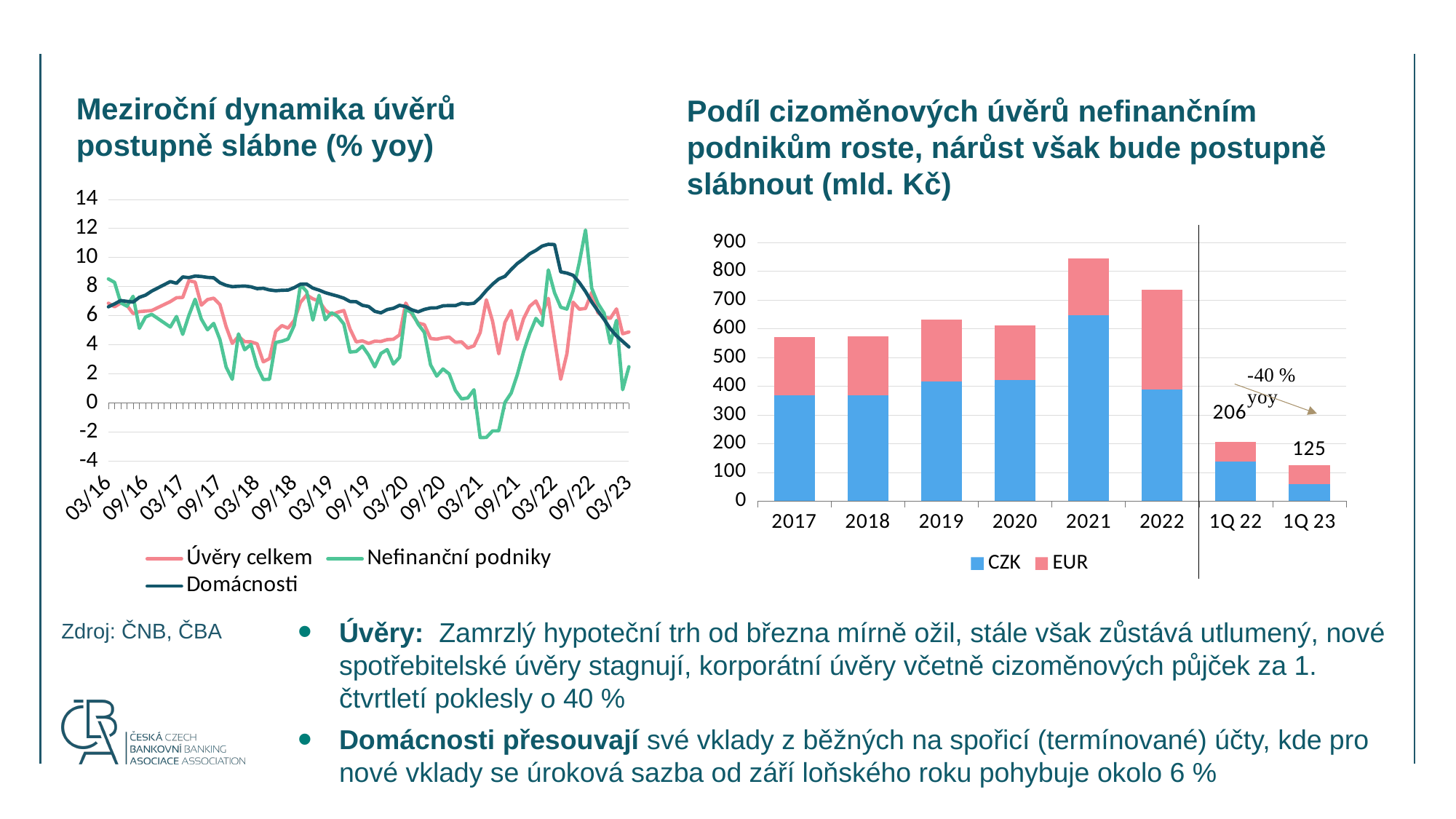
In the right chart, what is the total value of the bar for 1Q 23? 125 In the left chart, does the Domácnosti series rise or fall between 03/22 and 03/23? fall In the left chart, is the value of Nefinanční podniky at its peak around 09/22 greater or less than 10? greater How many categories are shown on the x axis of the right chart? 8 What kind of chart is the right chart titled 'Podíl cizoměnových úvěrů nefinančním podnikům roste...'? bar chart In the left chart, is the value of Nefinanční podniky around 03/21 greater or less than 0? less In the right chart, what is the difference between the totals for 1Q 22 and 1Q 23? 81 In the right chart, is the total for 2021 greater or less than 800? greater How many series does the legend of the left chart list? 3 In the right chart, what is the total value of the bar for 1Q 22? 206 What kind of chart is the left chart titled 'Meziroční dynamika úvěrů postupně slábne (% yoy)'? line chart In the right chart, which year has the highest total bar? 2021